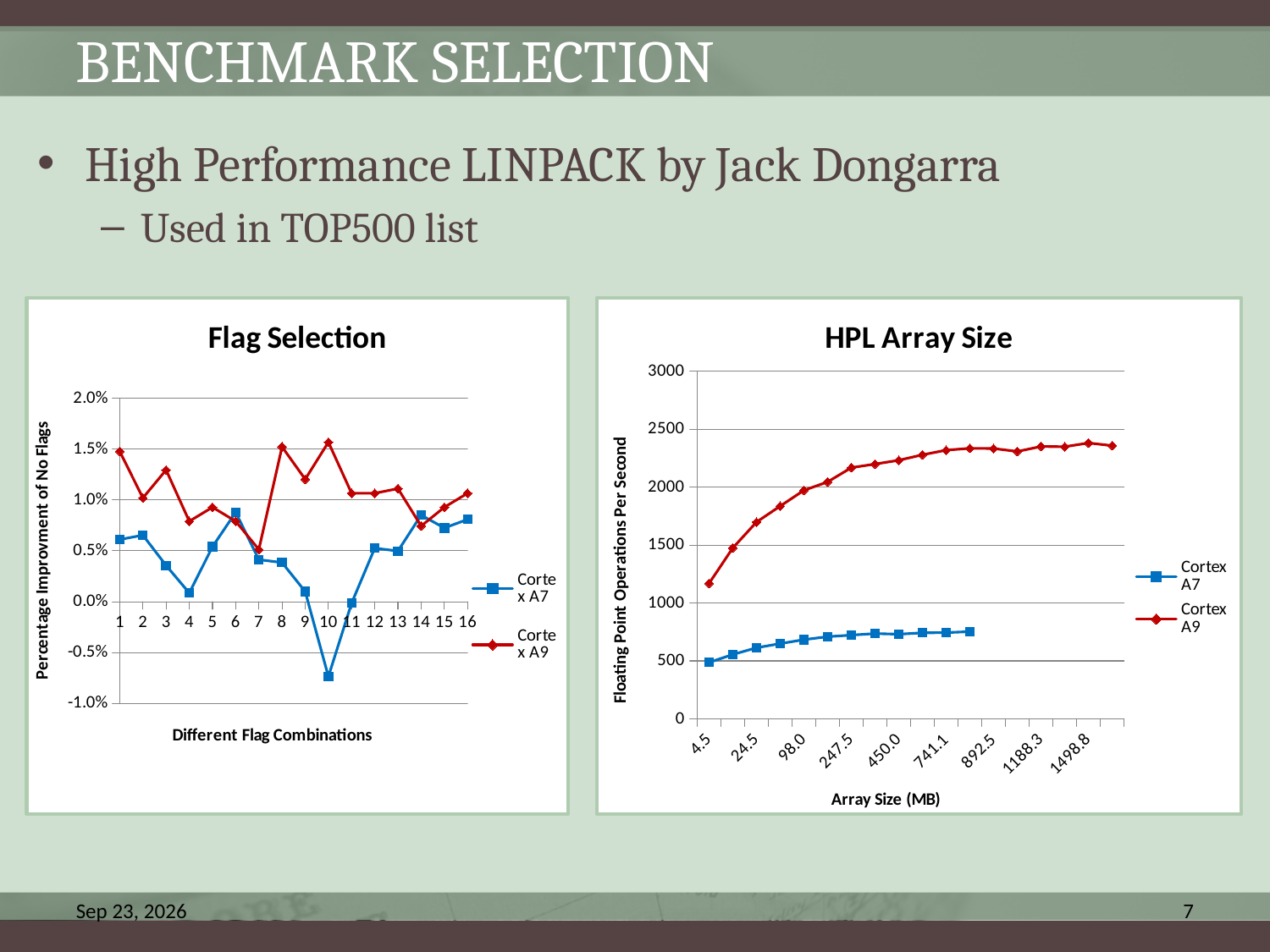
How many flag combinations are shown on the x axis of the Flag Selection chart? 16 What kind of chart is the HPL Array Size chart? line chart In the Flag Selection chart, which series has the larger value at flag combination 8, Cortex A7 or Cortex A9? Cortex A9 What is the y-axis title of the HPL Array Size chart? Floating Point Operations Per Second In the HPL Array Size chart, which series has the larger value at array size 450.0, Cortex A7 or Cortex A9? Cortex A9 In the Flag Selection chart, at which flag combination does Cortex A7 reach its lowest value? 10 In the HPL Array Size chart, do the Cortex A9 values generally rise or fall as array size increases? rise In the Flag Selection chart, is the Cortex A9 value at flag combination 1 greater or less than 1.0%? greater What kind of chart is the Flag Selection chart? line chart In the HPL Array Size chart, is the Cortex A9 value at array size 4.5 greater or less than 1000? greater In the Flag Selection chart, is the Cortex A7 value at flag combination 10 greater or less than 0.0%? less How many series does the legend of the Flag Selection chart list? 2